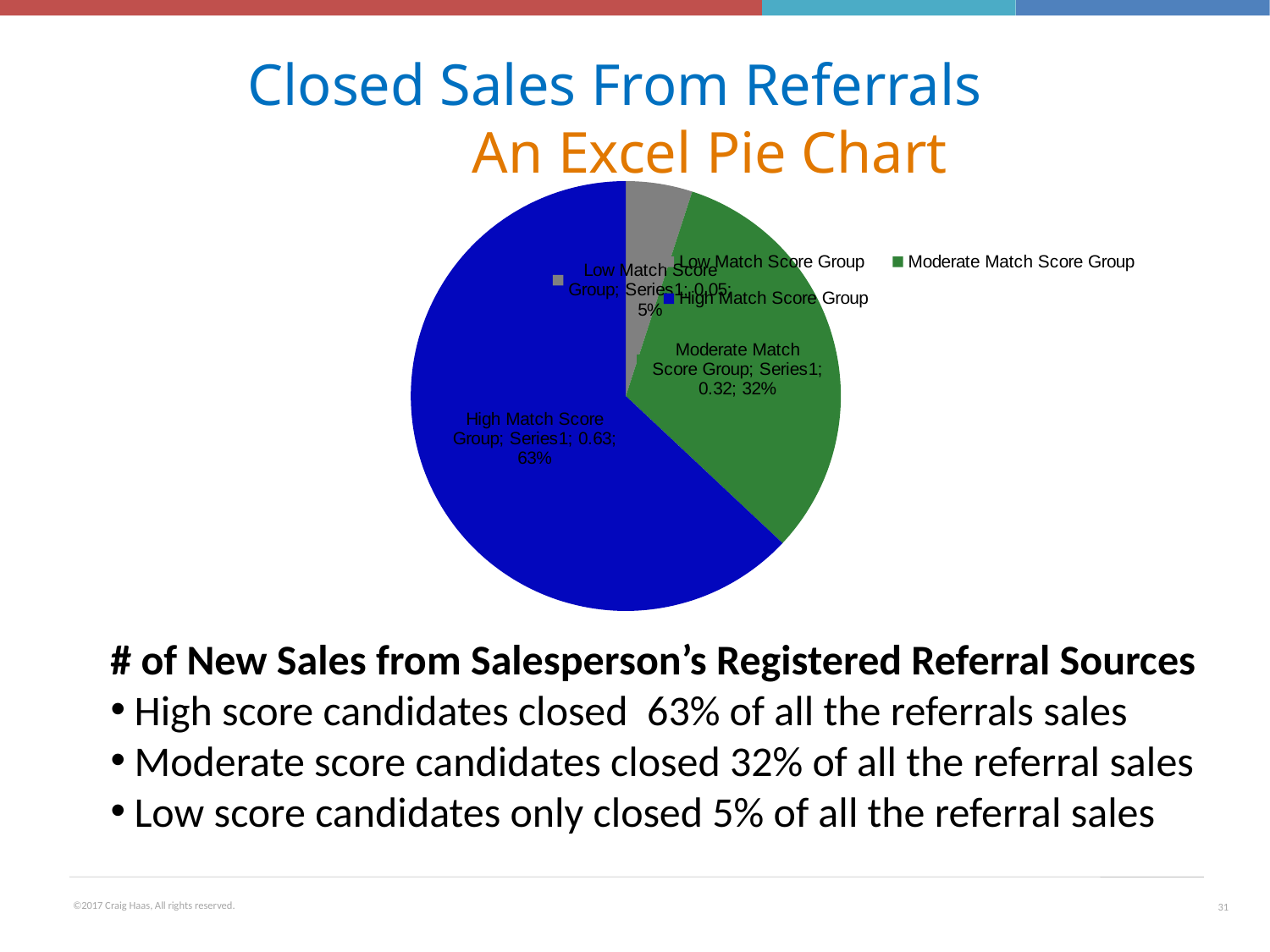
What is the difference in percentage points between the High Match Score Group and the Moderate Match Score Group slices? 31 What percentage of the pie does the Low Match Score Group slice represent? 5% Which group has the largest slice of the pie? High Match Score Group Which slice is larger, Moderate Match Score Group or Low Match Score Group? Moderate Match Score Group Which group has the smallest slice of the pie? Low Match Score Group What percentage of the pie does the High Match Score Group slice represent? 63% What value is printed in the data label for the High Match Score Group slice? 0.63 What value is printed in the data label for the Moderate Match Score Group slice? 0.32 What percentage of the pie does the Moderate Match Score Group slice represent? 32% What kind of chart is shown on the slide? Pie chart How many entries does the legend list? 3 How many slices does the pie chart have? 3